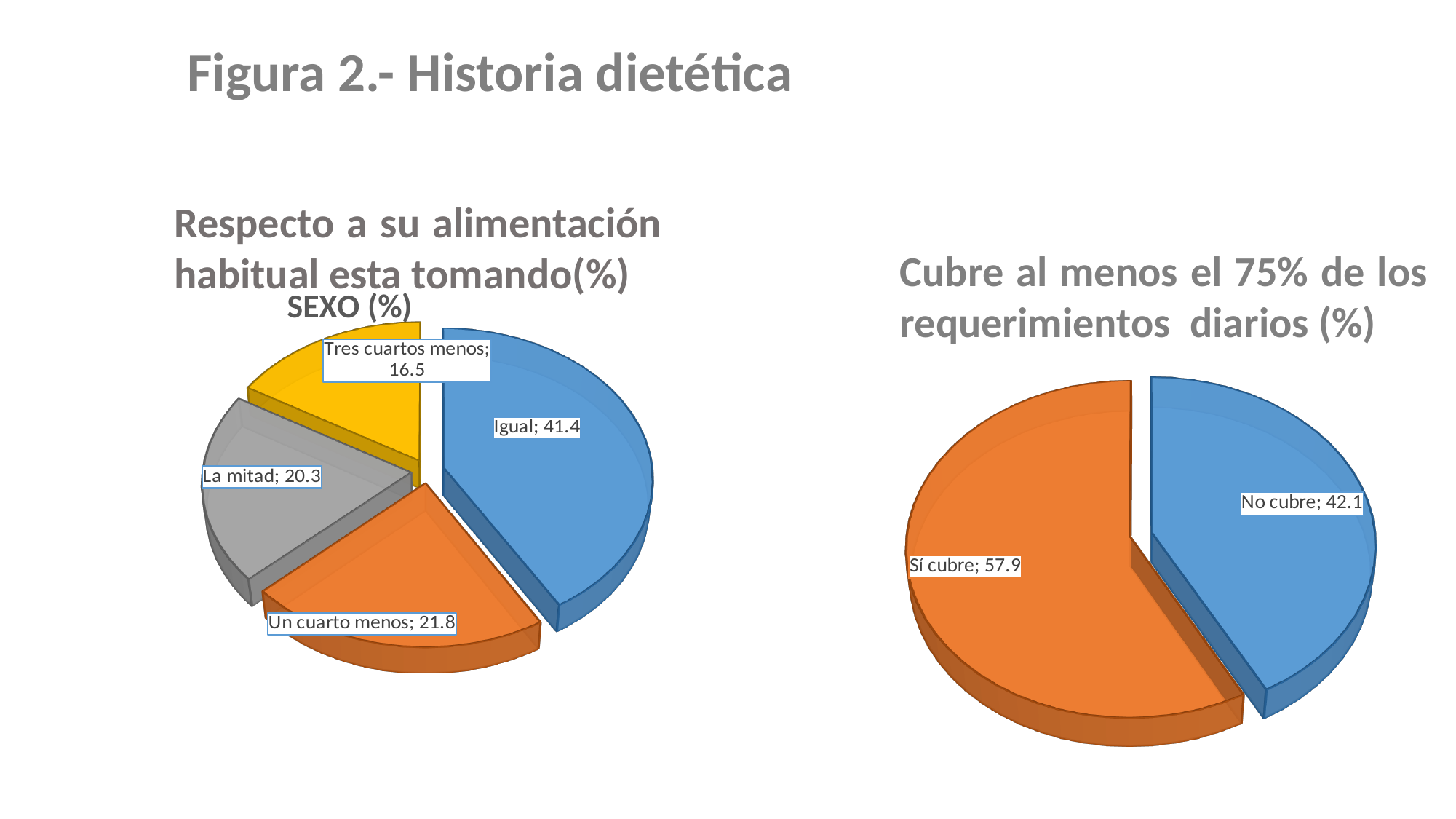
In the left chart (Respecto a su alimentación habitual esta tomando), what is the value for "Igual"? 41.4 In the right chart (Cubre al menos el 75% de los requerimientos diarios), what is the value for "No cubre"? 42.1 What type of chart is the right chart (Cubre al menos el 75% de los requerimientos diarios)? Pie chart In the right chart (Cubre al menos el 75% de los requerimientos diarios), what is the difference between "Sí cubre" and "No cubre"? 15.8 In the left chart (Respecto a su alimentación habitual esta tomando), which category has the largest slice? Igual In the right chart (Cubre al menos el 75% de los requerimientos diarios), what is the value for "Sí cubre"? 57.9 In the left chart (Respecto a su alimentación habitual esta tomando), which category has the smallest slice? Tres cuartos menos In the right chart (Cubre al menos el 75% de los requerimientos diarios), which is larger, "Sí cubre" or "No cubre"? Sí cubre In the left chart (Respecto a su alimentación habitual esta tomando), what is the value for "Tres cuartos menos"? 16.5 In the left chart (Respecto a su alimentación habitual esta tomando), what is the value for "La mitad"? 20.3 In the left chart (Respecto a su alimentación habitual esta tomando), how many slices does the pie have? 4 In the left chart (Respecto a su alimentación habitual esta tomando), what is the difference between "Igual" and "Un cuarto menos"? 19.6